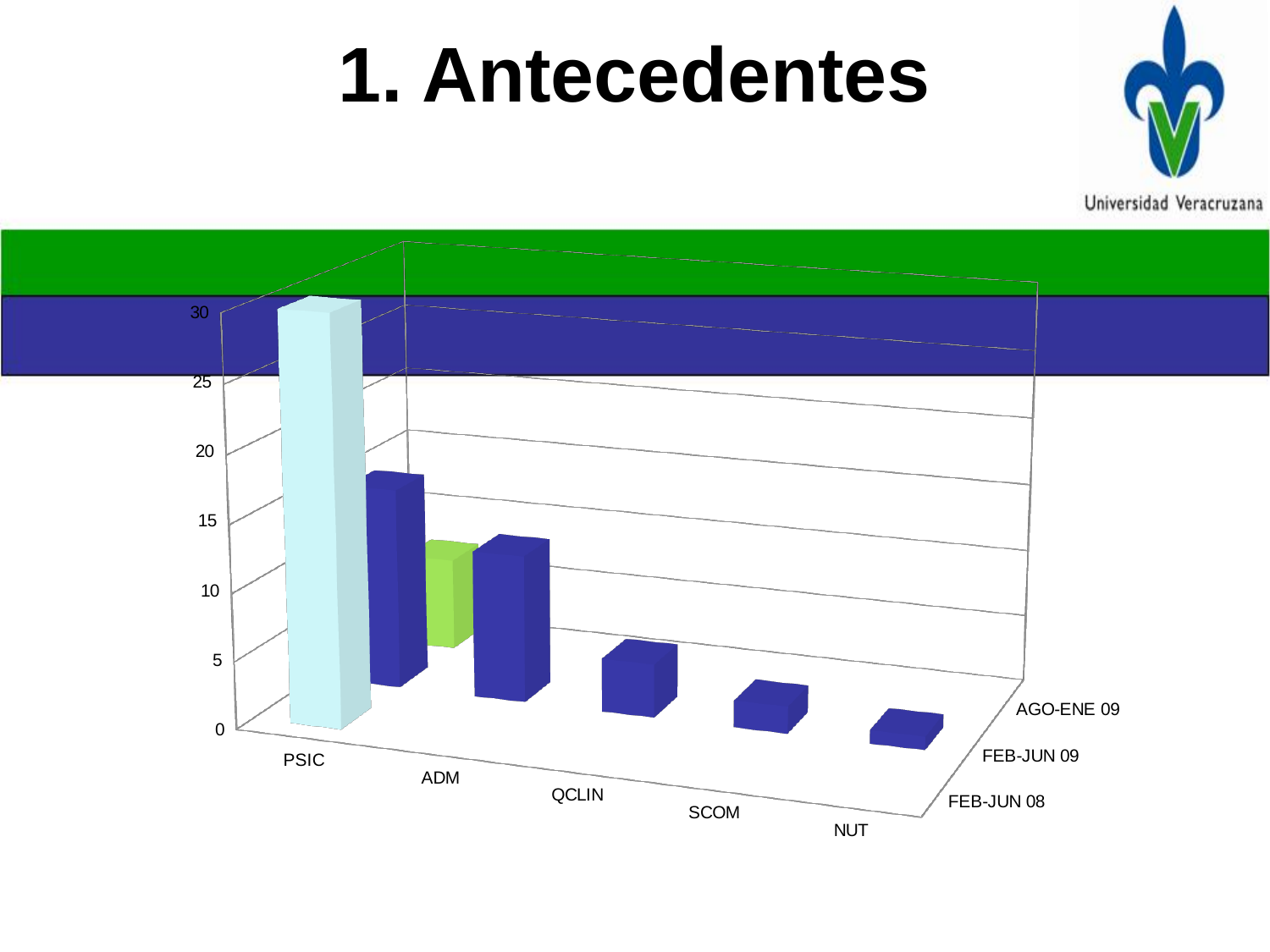
Which category has the tallest bar in the chart? PSIC Which category has the shortest bar in the chart? NUT Do the bar heights generally rise or fall moving from PSIC to NUT along the x axis? fall Which has a larger value, ADM or SCOM? ADM Is the value for NUT greater or less than 5? less Is the value for PSIC greater or less than 25? greater Which has a larger value, PSIC or ADM? PSIC Is the value for SCOM greater or less than 10? less What are the three period labels shown on the depth axis of the chart? FEB-JUN 08, FEB-JUN 09, AGO-ENE 09 What kind of chart is shown on the slide? bar chart How many categories are labelled along the x axis of the chart? 5